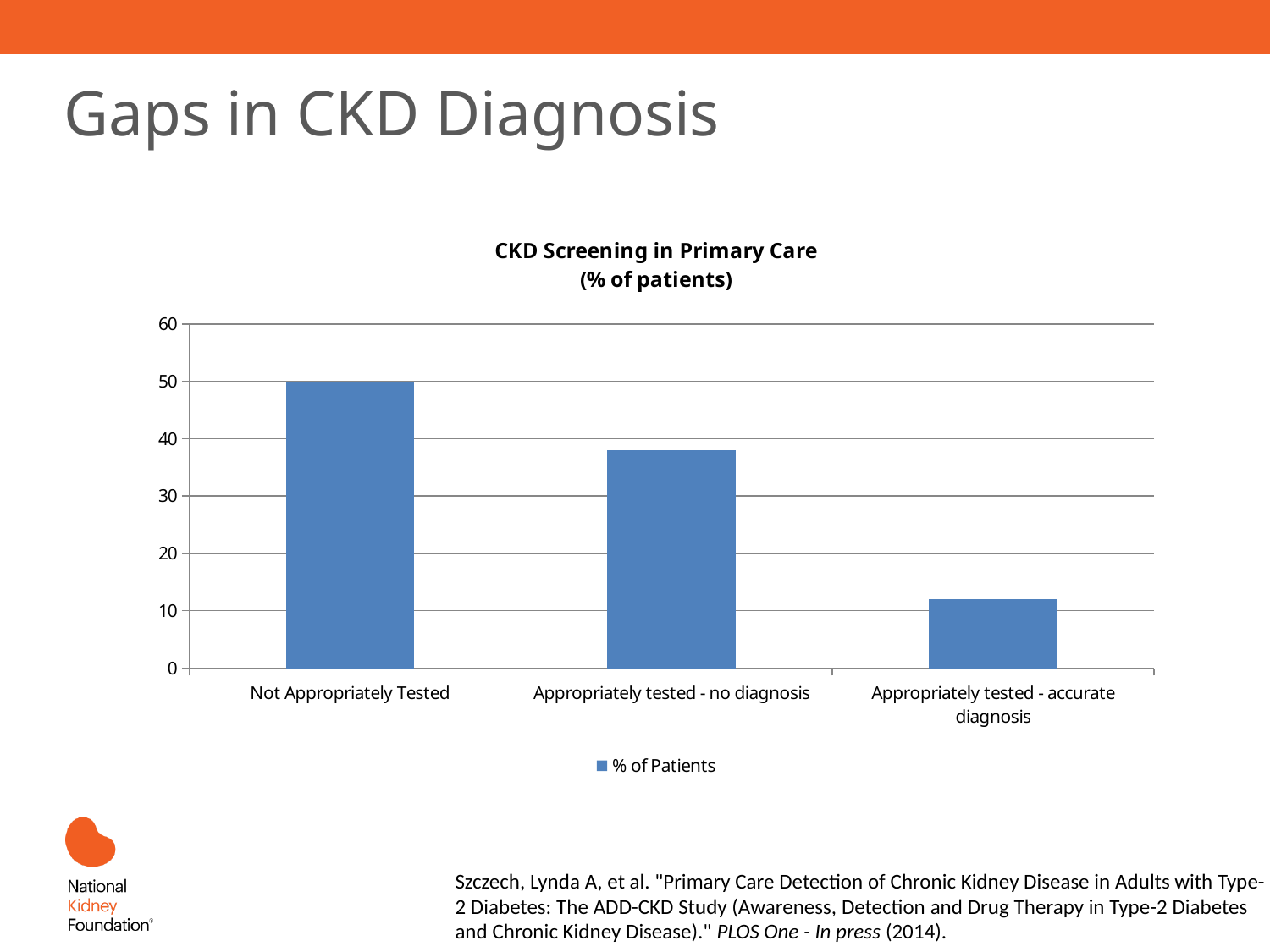
Which category has the lowest value? Appropriately tested - accurate diagnosis Do the values rise or fall from left to right along the x axis? fall How many categories are shown on the x axis of the chart? 3 Which is larger, the value for Appropriately tested - no diagnosis or the value for Appropriately tested - accurate diagnosis? Appropriately tested - no diagnosis How many series does the legend list? 1 Is the value for Appropriately tested - accurate diagnosis greater or less than 20? less Is the value for Appropriately tested - no diagnosis greater or less than 30? greater Is the value for Appropriately tested - no diagnosis greater or less than 40? less Which category has the highest value? Not Appropriately Tested What is the title of the chart? CKD Screening in Primary Care (% of patients) What type of chart is shown on the slide? bar chart What is the value for Not Appropriately Tested? 50